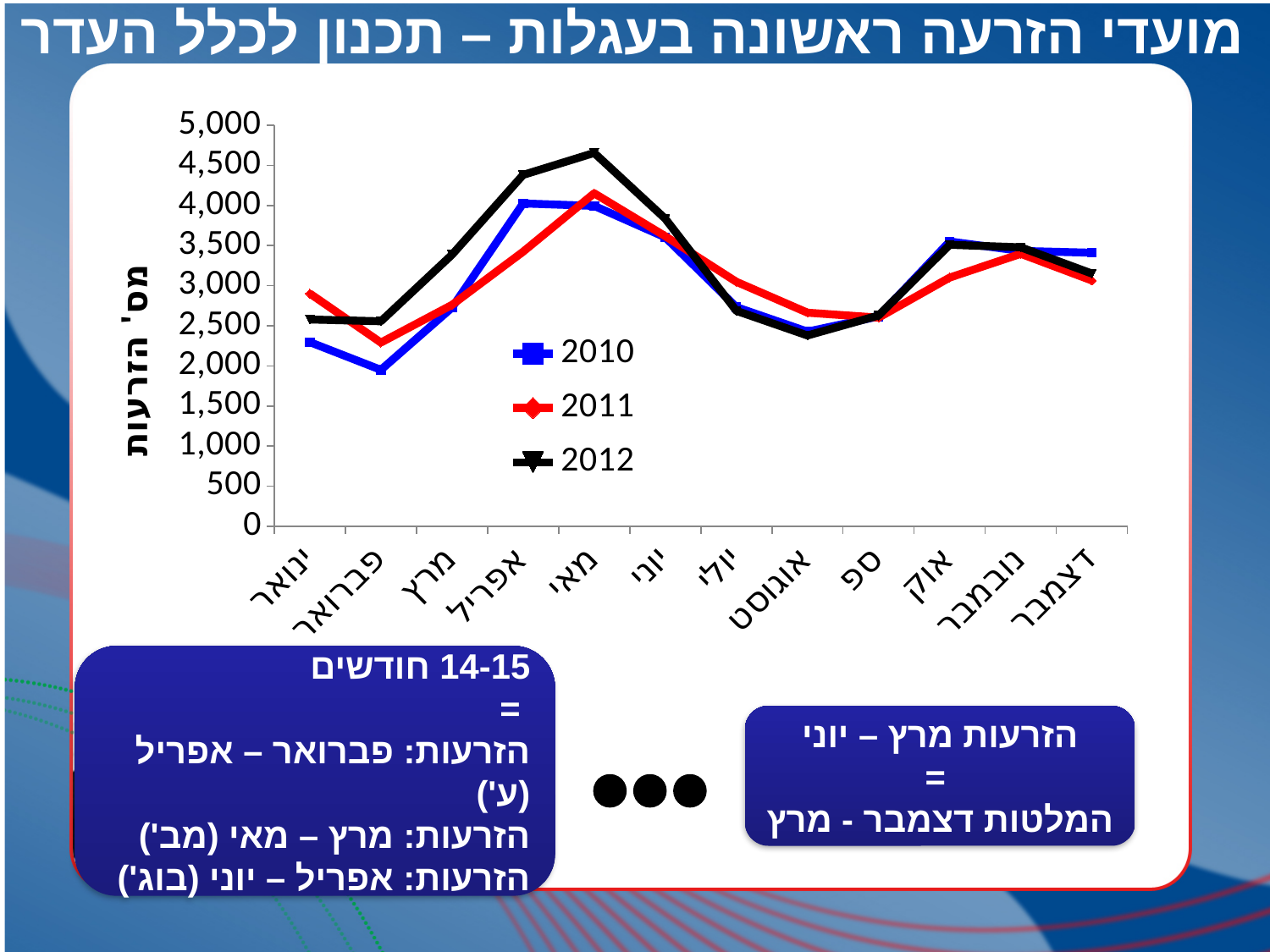
How many categories (months) are shown on the x axis? 12 How many series does the legend list? 3 In which month does the 2012 series reach its highest value? מאי Is the value for 2010 in פברואר greater or less than 2,500? less In which month does the 2010 series reach its lowest value? פברואר In which month does the 2011 series reach its highest value? מאי Does the 2012 series rise or fall from מאי to אוגוסט? Fall In מאי, which series has the larger value, 2012 or 2010? 2012 What kind of chart is shown on the slide? Line chart In ינואר, which series has the larger value, 2011 or 2010? 2011 What colour is the line for the 2011 series? Red Is the value for 2012 in אפריל greater or less than 4,000? greater